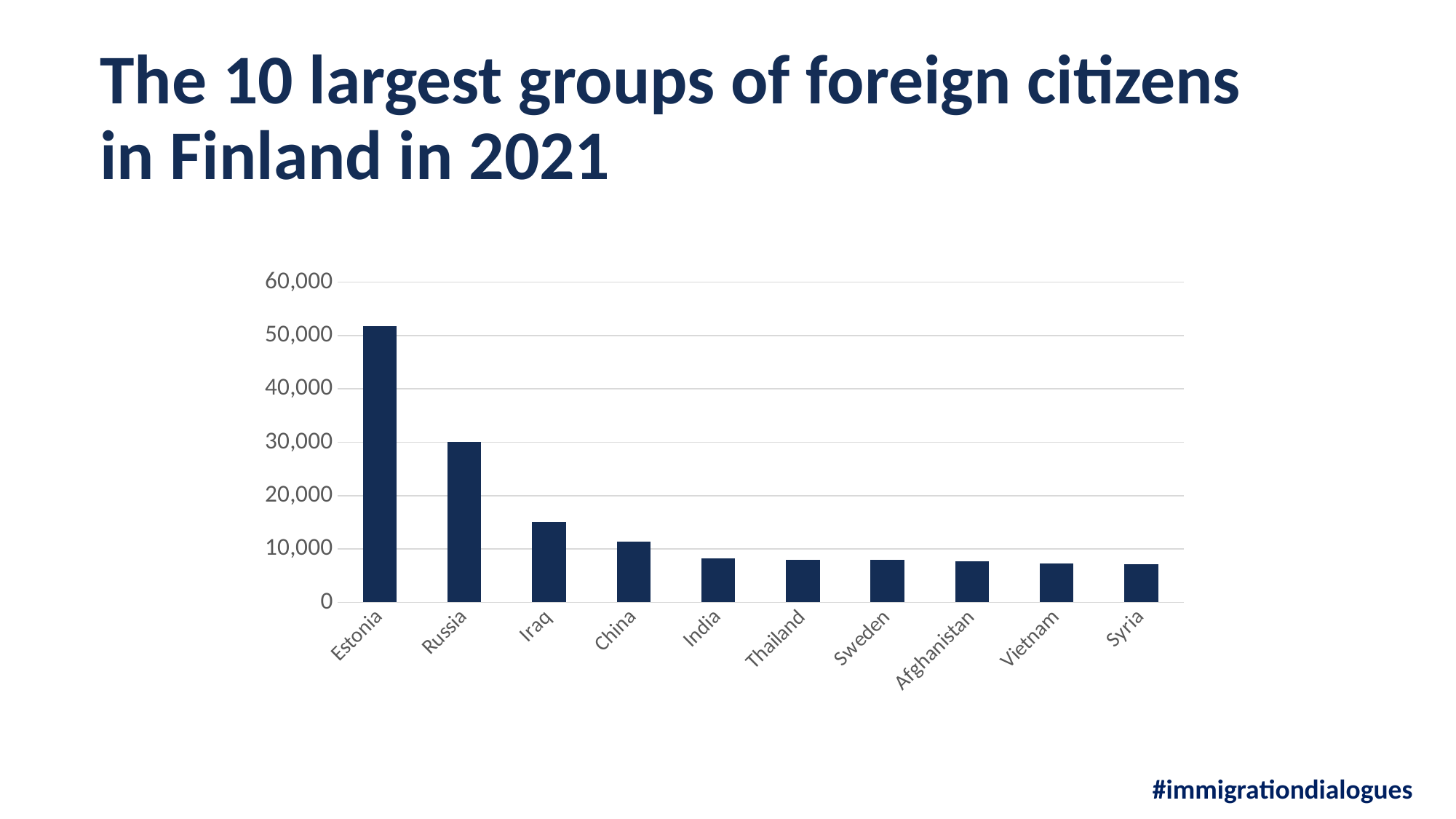
Which country has the highest bar in the chart? Estonia What is the title of the slide containing the chart? The 10 largest groups of foreign citizens in Finland in 2021 Is the value for Estonia greater or less than 60,000? less Is the value for China greater or less than 10,000? greater Is the value for Estonia greater or less than 50,000? greater Do the bar values rise or fall from left to right along the x axis? fall Which has a larger value, Russia or Iraq? Russia What kind of chart is shown on the slide? bar chart How many countries are shown on the x axis of the chart? 10